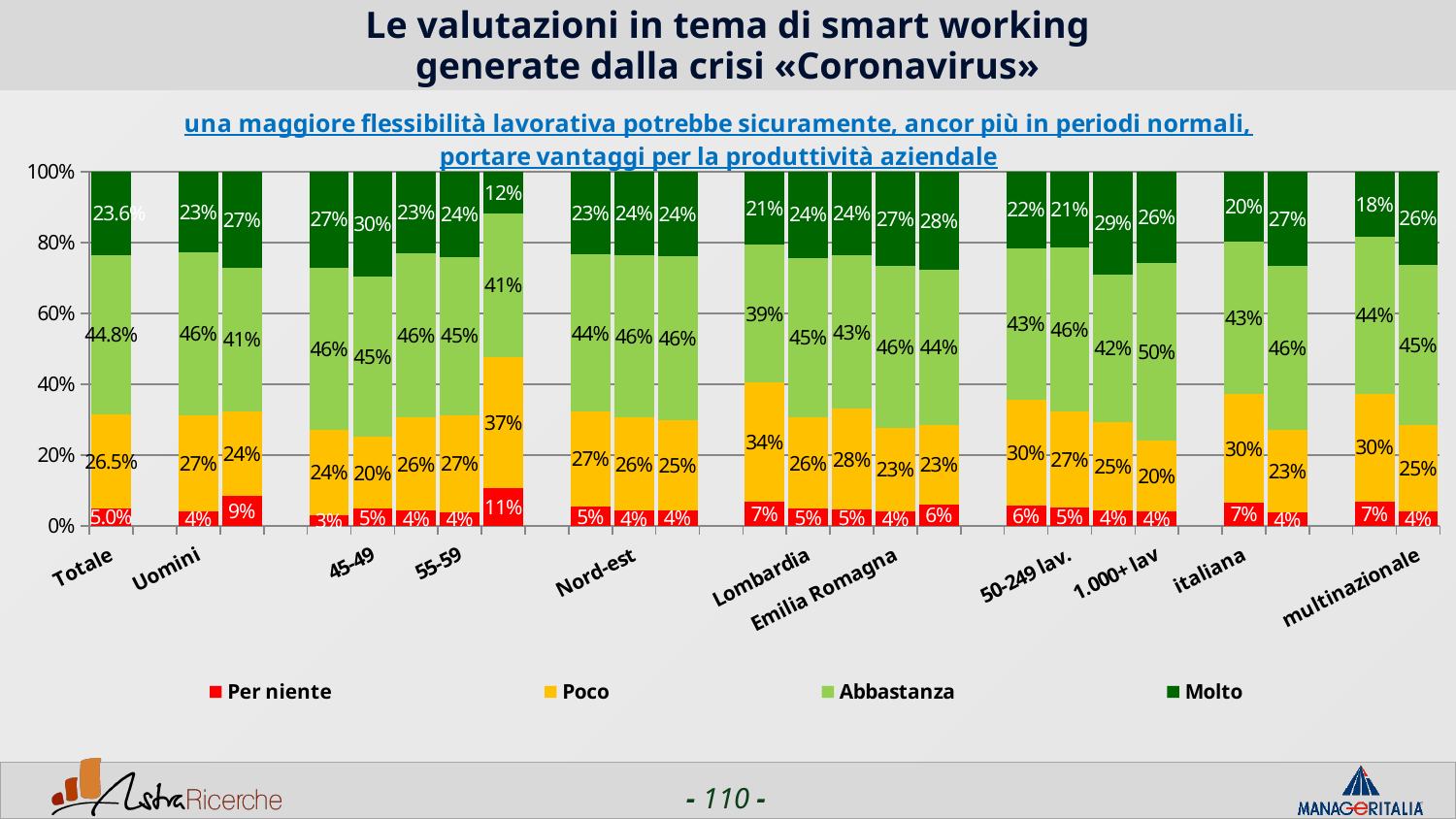
What is the difference between the 'Abbastanza' and 'Molto' values for Totale? 21.2% What is the 'Abbastanza' value for 1.000+ lav? 50% Which colour represents the 'Per niente' series? Red What is the 'Per niente' value for Totale? 5.0% What is the 'Molto' value for Totale? 23.6% How many series does the legend list? 4 What is the 'Molto' value for 45-49? 30% What are the four series listed in the legend? Per niente, Poco, Abbastanza, Molto What is the 'Abbastanza' value for Totale? 44.8% What is the 'Poco' value for Totale? 26.5% For Totale, which is larger: the 'Abbastanza' share or the 'Poco' share? Abbastanza What type of chart is shown on the slide? Stacked bar chart